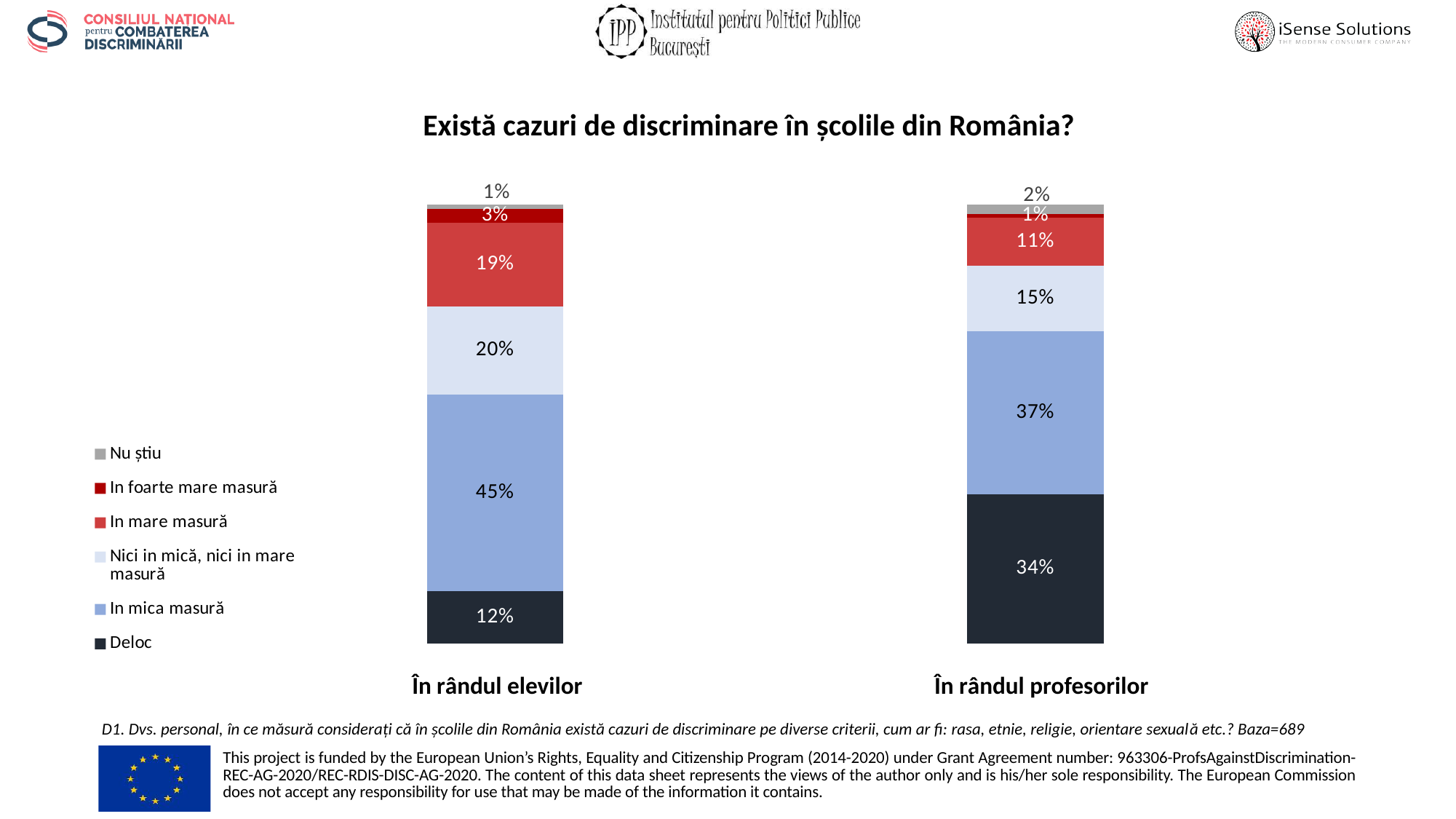
What is the title of the chart? Există cazuri de discriminare în școlile din România? What is the value for "In mare masură" in the "În rândul elevilor" bar? 19% What is the value for "In mica masură" in the "În rândul elevilor" bar? 45% How many series does the legend list? 6 How many bars (categories) are plotted in the chart? 2 What is the difference between the "Deloc" values for "În rândul profesorilor" and "În rândul elevilor"? 22% Which segment is the largest in the "În rândul elevilor" bar? In mica masură What kind of chart is shown on the slide? Stacked bar chart What is the value for "Deloc" in the "În rândul profesorilor" bar? 34% What is the value for "Nu știu" in the "În rândul profesorilor" bar? 2% Which segment is the smallest in the "În rândul profesorilor" bar? In foarte mare masură Which bar has the larger value for "Nici in mică, nici in mare masură": "În rândul elevilor" or "În rândul profesorilor"? În rândul elevilor